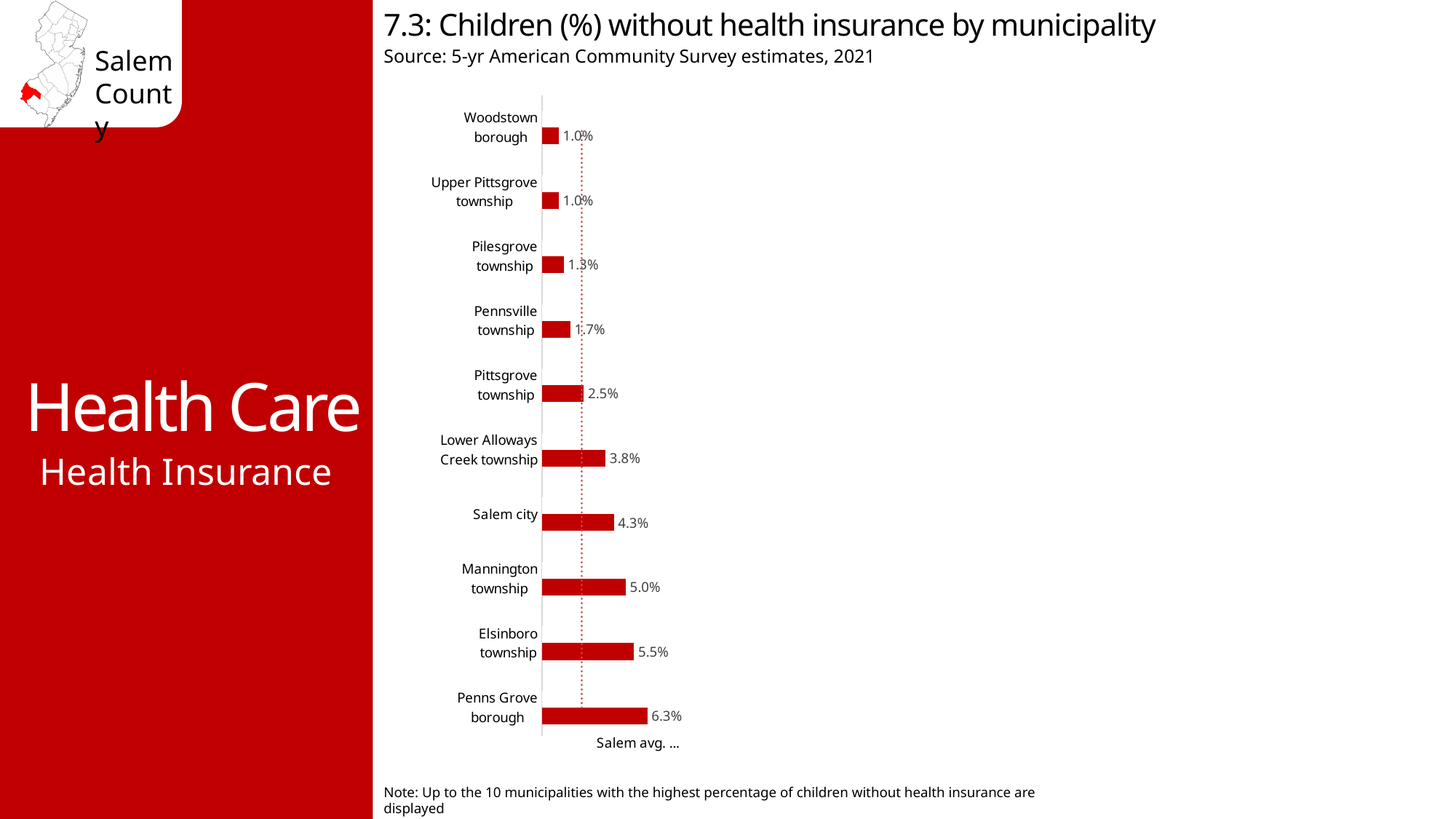
What percentage is shown for Lower Alloways Creek township? 3.8% What is the title of the chart? 7.3: Children (%) without health insurance by municipality Which has a higher value, Salem city or Lower Alloways Creek township? Salem city Which has a lower value, Pilesgrove township or Pennsville township? Pilesgrove township What is the value shown for Salem city? 4.3% How many municipalities are shown in the chart? 10 What is the difference between Mannington township and Pittsgrove township? 2.5% What kind of chart is shown on the slide? Bar chart What is the value for Pennsville township? 1.7% What percentage of children are without health insurance in Penns Grove borough? 6.3% What is the difference between the values for Penns Grove borough and Elsinboro township? 0.8% Which municipality has the highest percentage of children without health insurance? Penns Grove borough